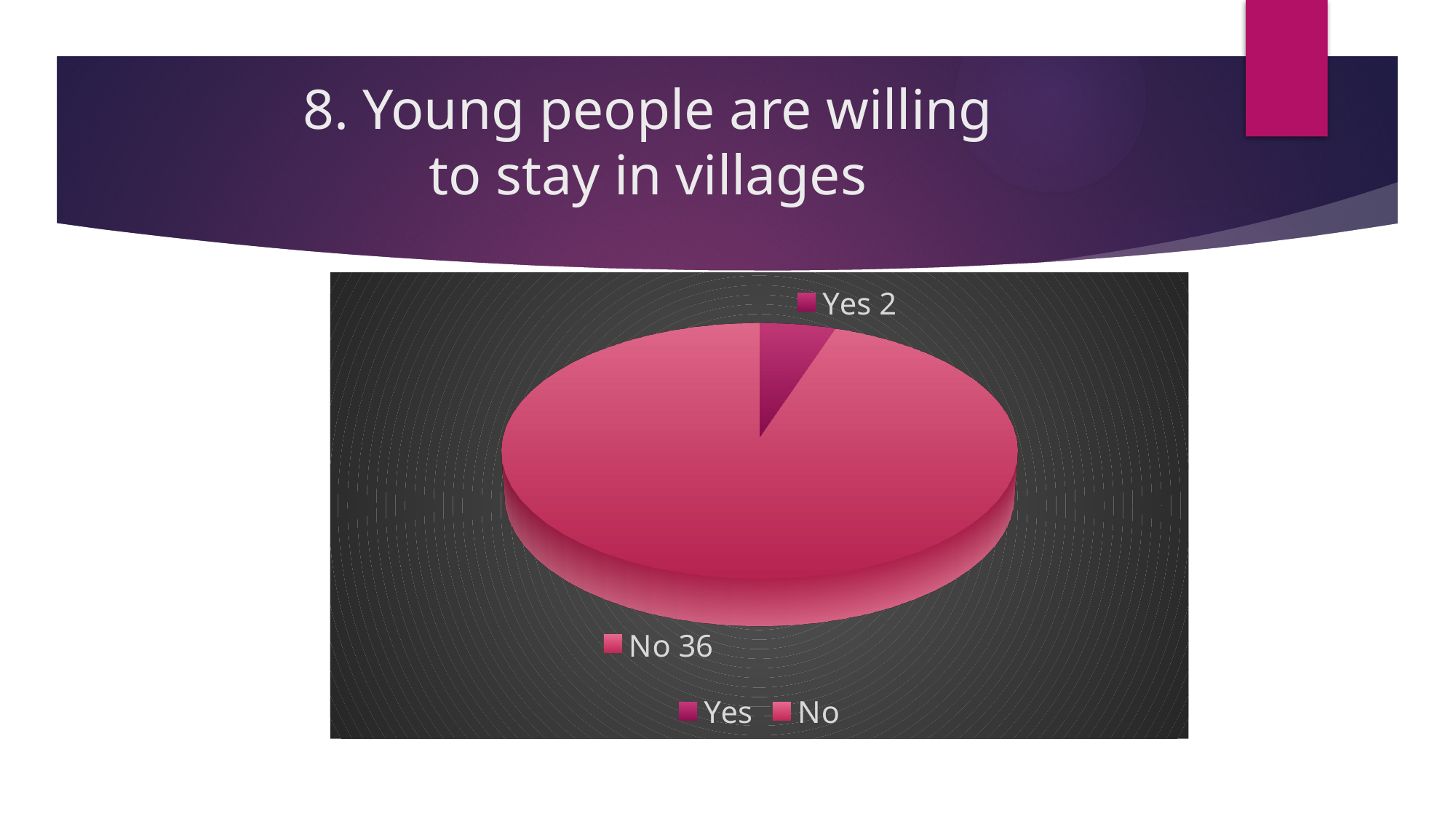
Which category has the largest slice? No How many slices does the pie chart have? 2 Which category has the smallest slice? Yes What is the title of the slide containing the chart? 8. Young people are willing to stay in villages Which is larger, the value for Yes or the value for No? No What kind of chart is shown on the slide? pie chart What is the value for Yes? 2 What is the value for No? 36 What are the legend entries of the chart? Yes, No How many entries does the legend list? 2 What is the difference between the values for No and Yes? 34 What is the total of all slices in the pie chart? 38